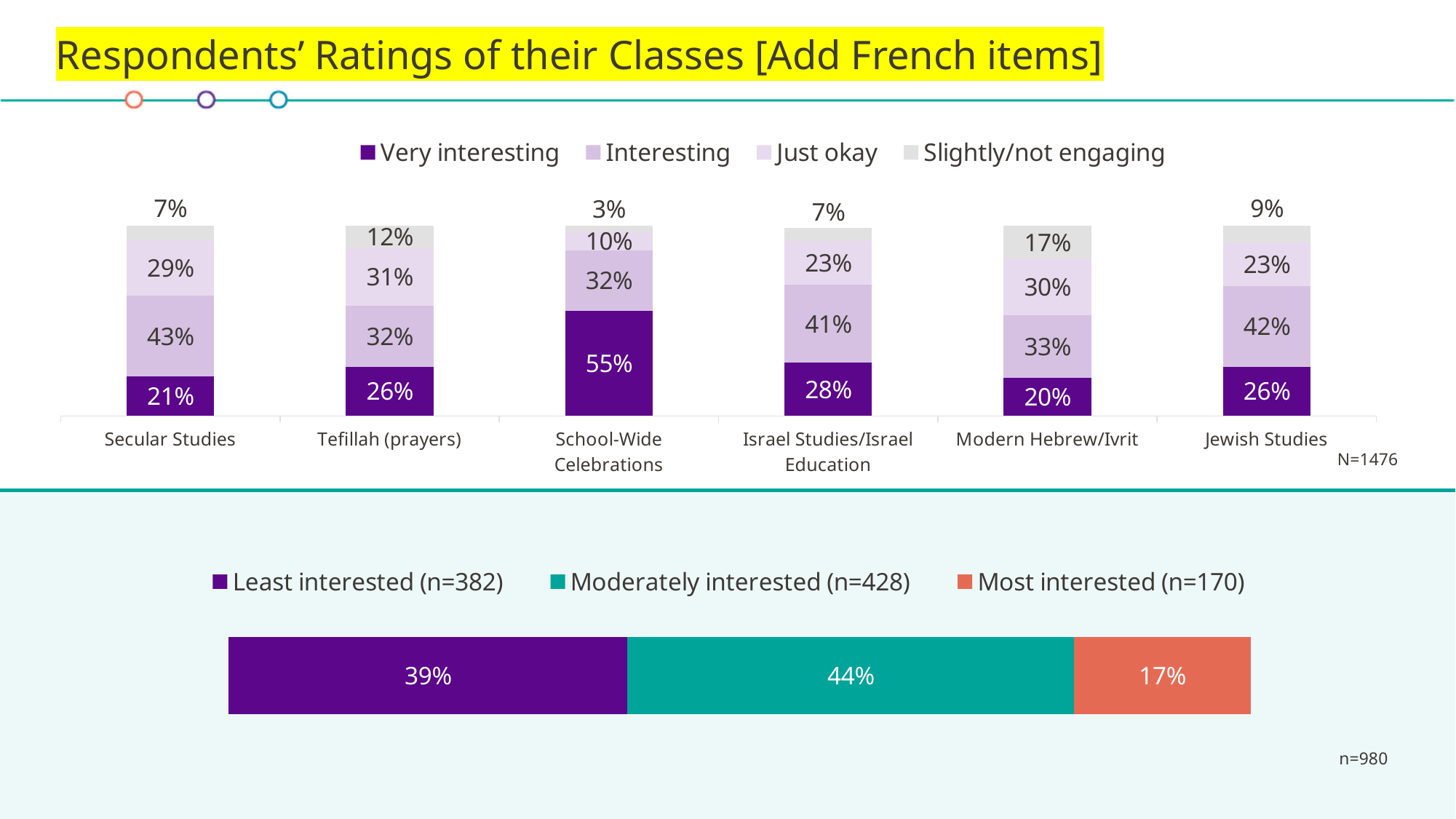
What kind of chart is the top chart? Stacked bar chart In the bottom chart, which group has the smallest share? Most interested In the top chart, what is the Just okay value for Modern Hebrew/Ivrit? 30% In the top chart, what percentage of respondents rated School-Wide Celebrations as Very interesting? 55% In the top chart, which class has the highest Very interesting percentage? School-Wide Celebrations In the top chart, which has a larger Slightly/not engaging share: Modern Hebrew/Ivrit or Jewish Studies? Modern Hebrew/Ivrit How many classes are shown along the x axis of the top chart? 6 What sample size is noted for the bottom chart? n=980 In the bottom chart, what percentage is Moderately interested? 44% In the top chart, which class has the lowest Very interesting percentage? Modern Hebrew/Ivrit In the top chart, what is the difference between the Interesting values for Secular Studies and Tefillah (prayers)? 11% How many series does the legend of the top chart list? 4